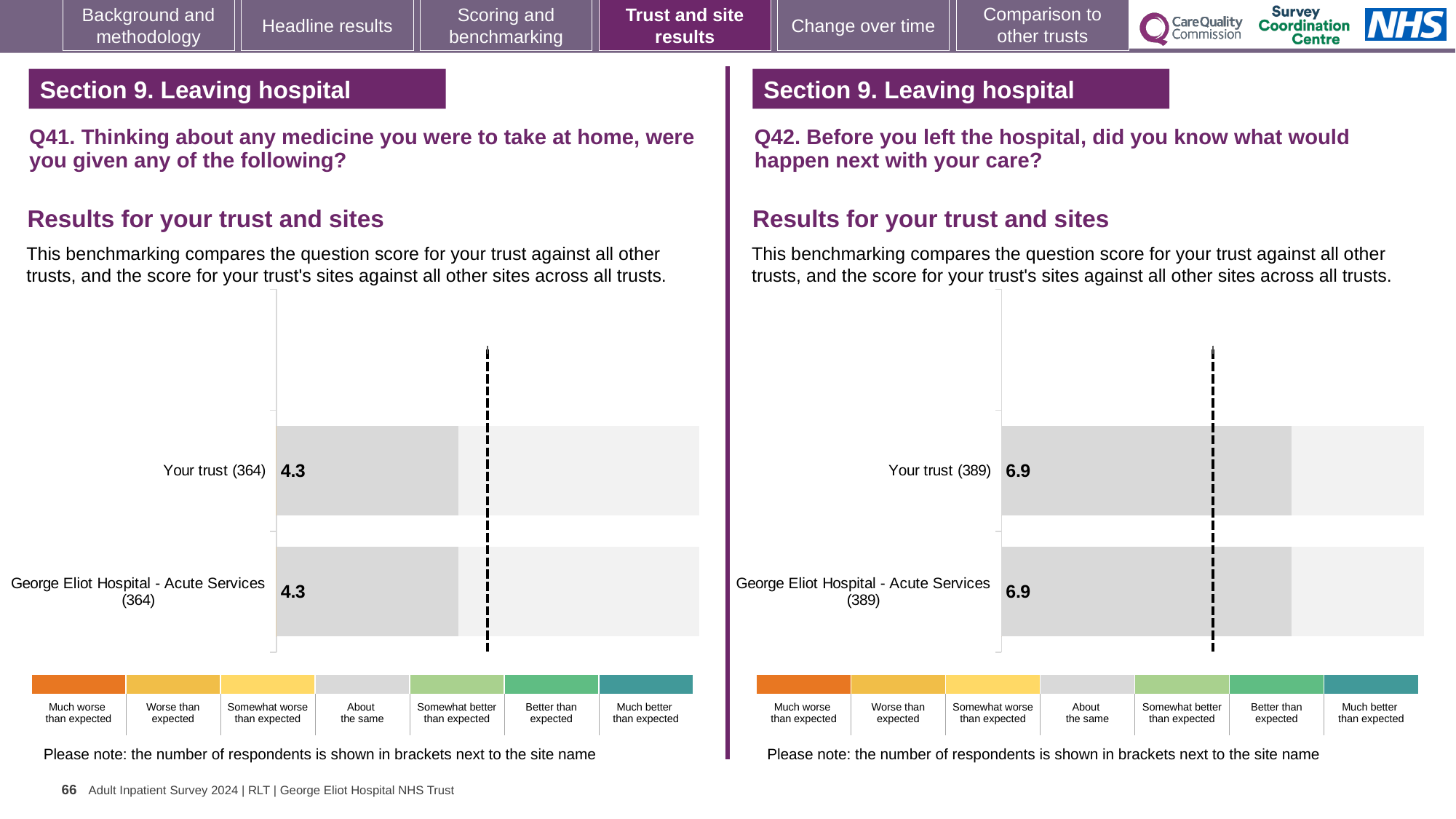
How many respondents are shown in brackets for Your trust in the Q42 chart on the right? 389 How many benchmark categories does the colour key below the Q41 chart on the left list? 7 In the Q41 chart on the left, what is the difference between the score for Your trust and the score for George Eliot Hospital - Acute Services? 0 How many bars are plotted in the Q41 chart on the left? 2 In the Q42 chart on the right, what is the score for George Eliot Hospital - Acute Services? 6.9 In the Q42 chart on the right, what is the difference between the score for Your trust and the score for George Eliot Hospital - Acute Services? 0 In the Q41 chart on the left, what is the score for Your trust? 4.3 What kind of chart is used for the Q42 results on the right? Bar chart In the Q42 chart on the right, what is the score for Your trust? 6.9 How many bars are plotted in the Q42 chart on the right? 2 How many respondents are shown in brackets for Your trust in the Q41 chart on the left? 364 In the Q41 chart on the left, what is the score for George Eliot Hospital - Acute Services? 4.3